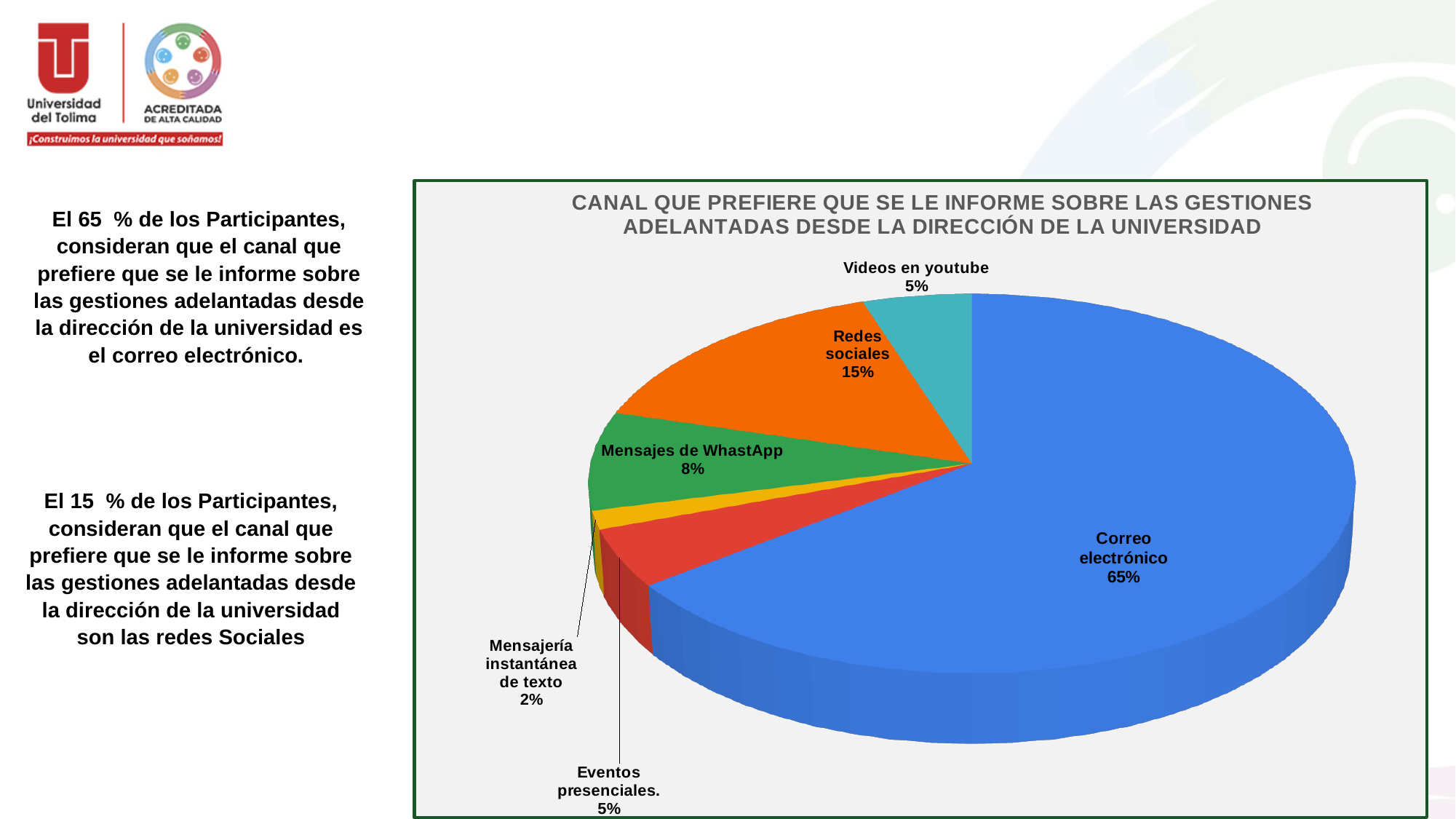
Which category has the largest slice of the pie? Correo electrónico Which category has the smallest slice of the pie? Mensajería instantánea de texto What is the value for Mensajería instantánea de texto? 2% What is the value for Redes sociales? 15% What is the value for Mensajes de WhastApp? 8% How many categories are shown in the pie chart? 6 What colour is the Correo electrónico slice? Blue What is the difference in percentage points between Correo electrónico and Redes sociales? 50 What kind of chart is shown on the slide? Pie chart Which is larger, Mensajes de WhastApp or Eventos presenciales? Mensajes de WhastApp What share of the pie does Correo electrónico have? 65% What is the value for Videos en youtube? 5%